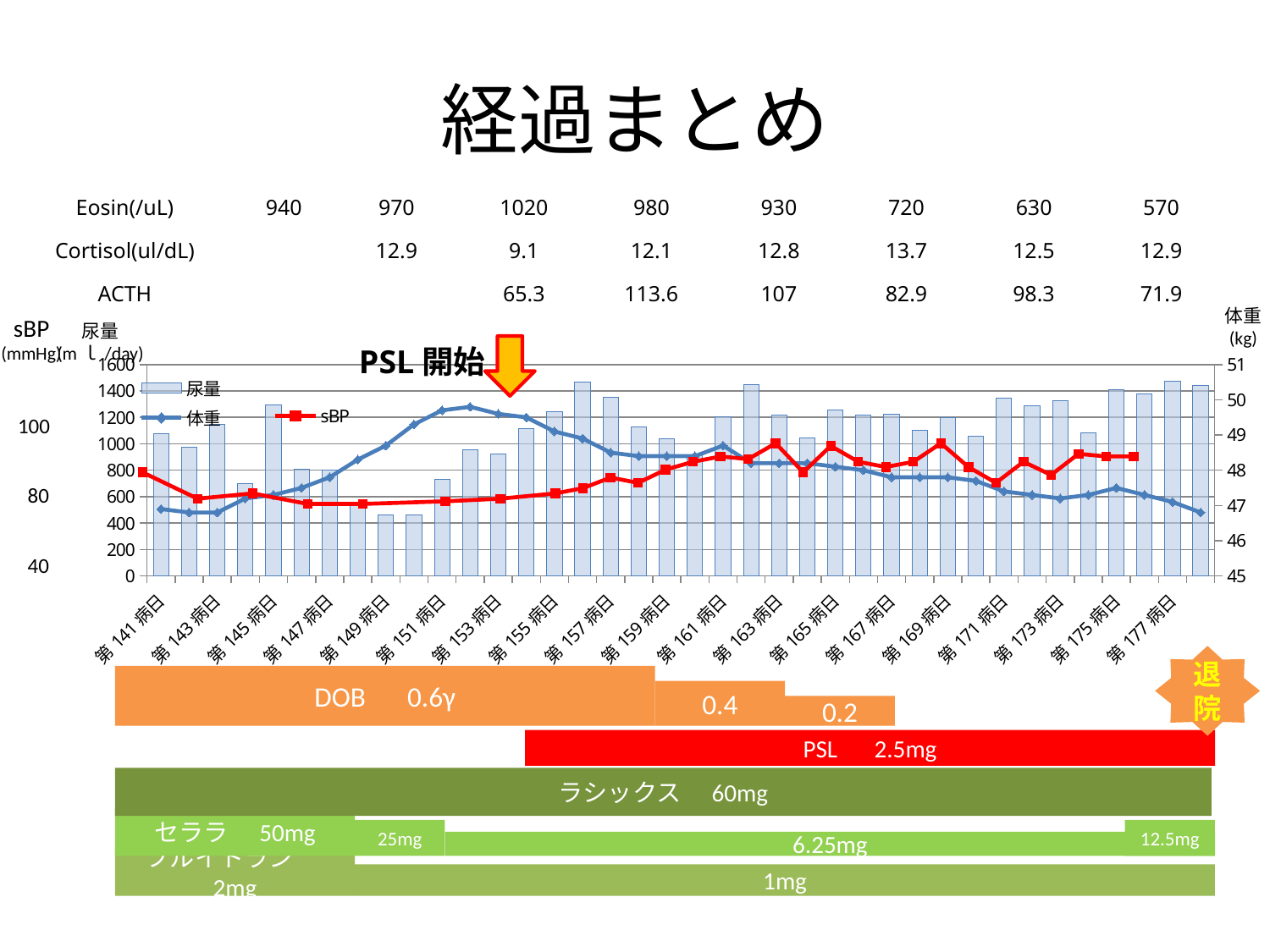
Does the 体重 line rise or fall from 第153病日 to 第177病日? fall Is the 体重 value for 第153病日 greater or less than 49? greater Which has the larger 体重 value, 第153病日 or 第177病日? 第153病日 Is the sBP value for 第147病日 greater or less than 80? less Which series is drawn as bars in the chart? 尿量 How many series does the chart legend list? 3 Which series is drawn with the red line in the chart? sBP Is the 尿量 value for 第145病日 greater or less than 1200? greater What kind of chart is shown on the slide? A combined bar and line chart Which has the larger 尿量 value, 第145病日 or 第149病日? 第145病日